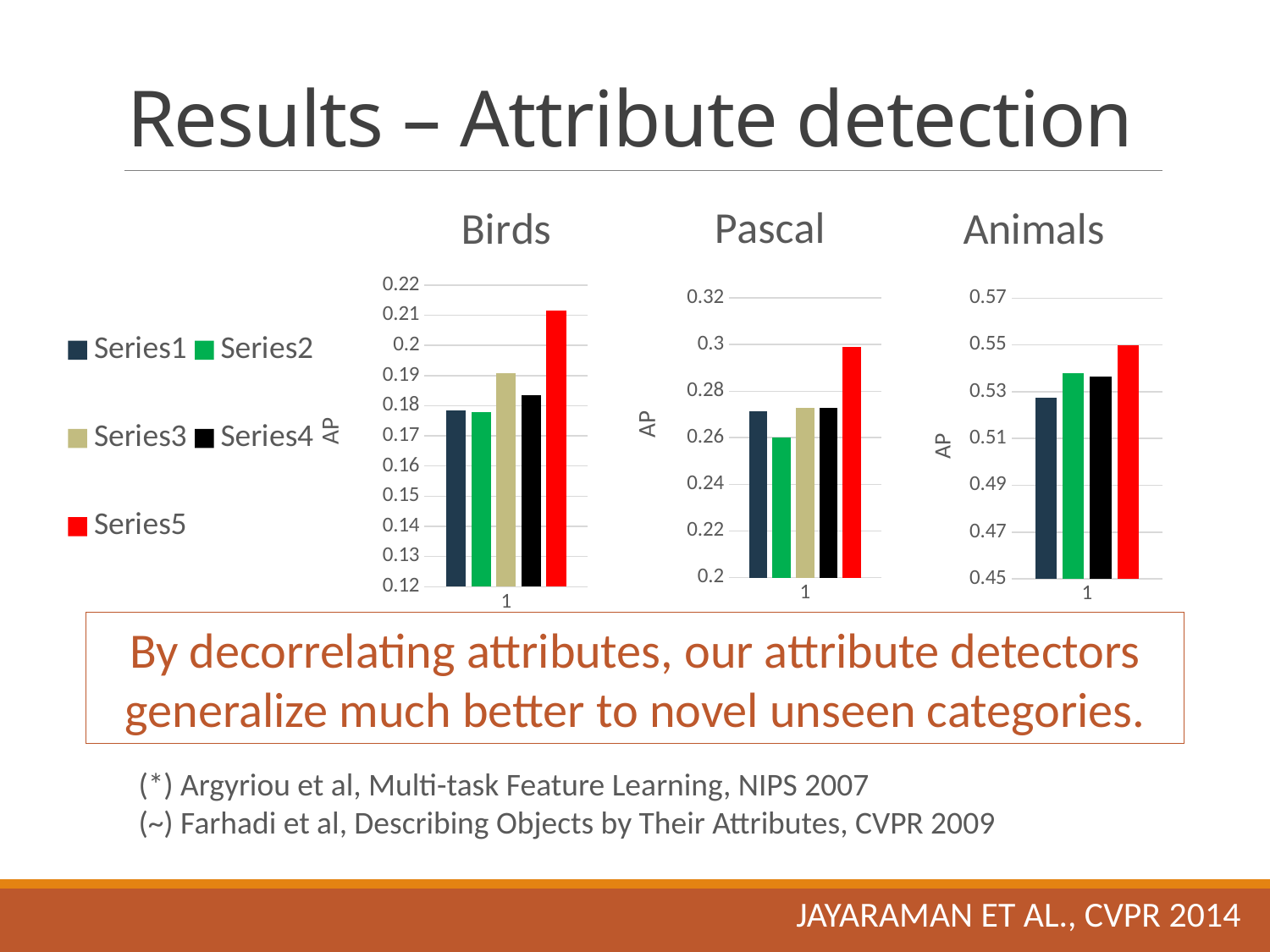
In the Pascal chart, which series has the lowest value? Series2 In the Animals chart, which series has the highest value? Series5 In the Pascal chart, is the value for Series2 greater or less than 0.28? less How many series does the legend list? 5 In the Animals chart, which series has the lowest value? Series1 In the Birds chart, which series has the highest value? Series5 How many bars are plotted in the Animals chart? 4 What kind of chart is the Birds chart? bar chart In the Birds chart, which is larger, Series3 or Series4? Series3 What is the label on the vertical axis of the Pascal chart? AP In the Animals chart, is the value for Series5 greater or less than 0.53? greater In the Birds chart, is the value for Series5 greater or less than 0.2? greater